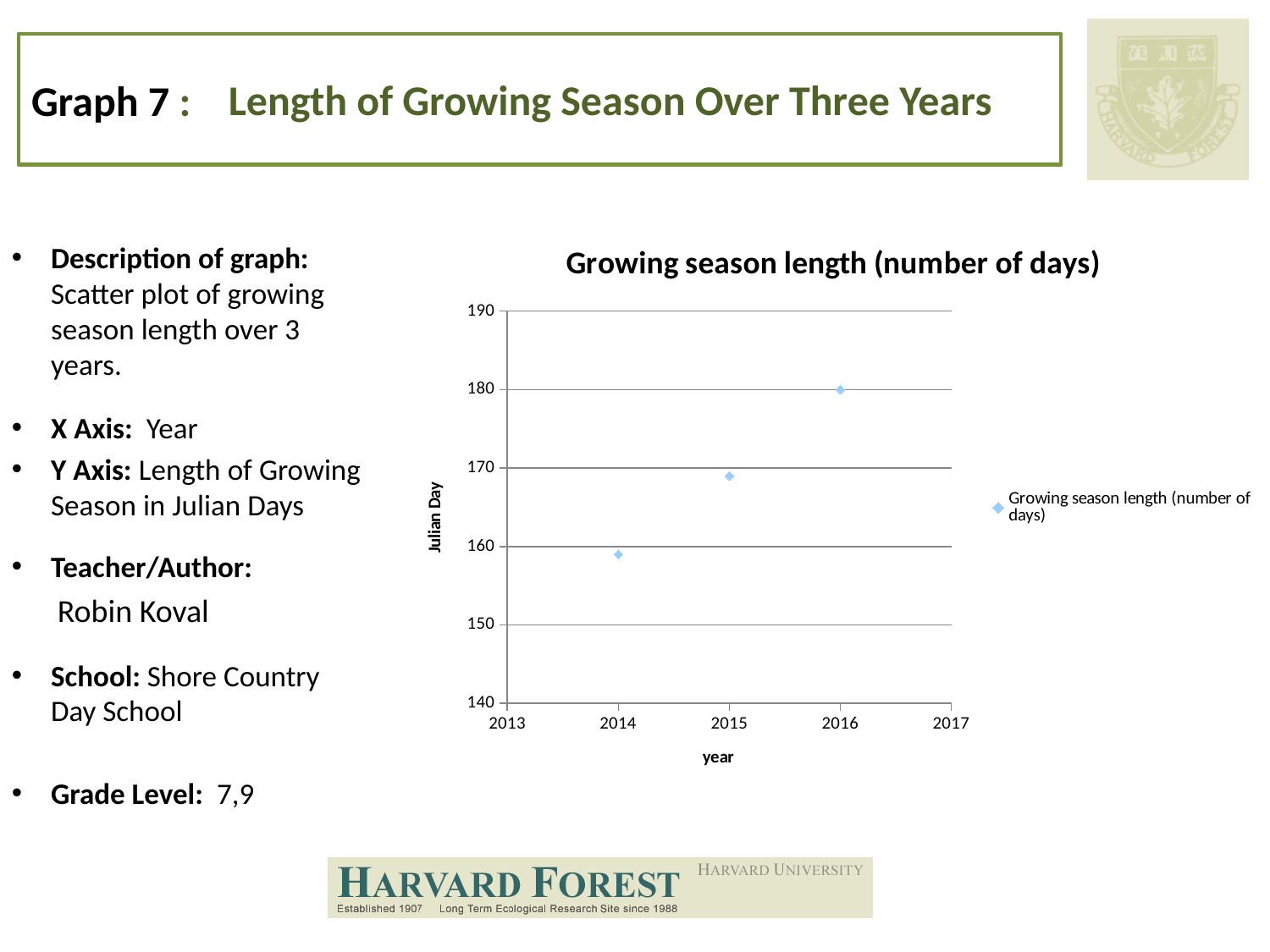
What kind of chart is shown on the slide? Scatter plot Which year has the shortest growing season in the chart? 2014 Which year has a larger growing season length, 2014 or 2015? 2015 How many series does the chart legend list? 1 What is the label on the chart's y axis? Julian Day Do the growing season length values rise or fall from 2014 to 2016? Rise Which year has the longest growing season in the chart? 2016 Is the growing season length for 2016 greater or less than 170? greater What is the title of the chart? Growing season length (number of days) How many data points are plotted in the chart? 3